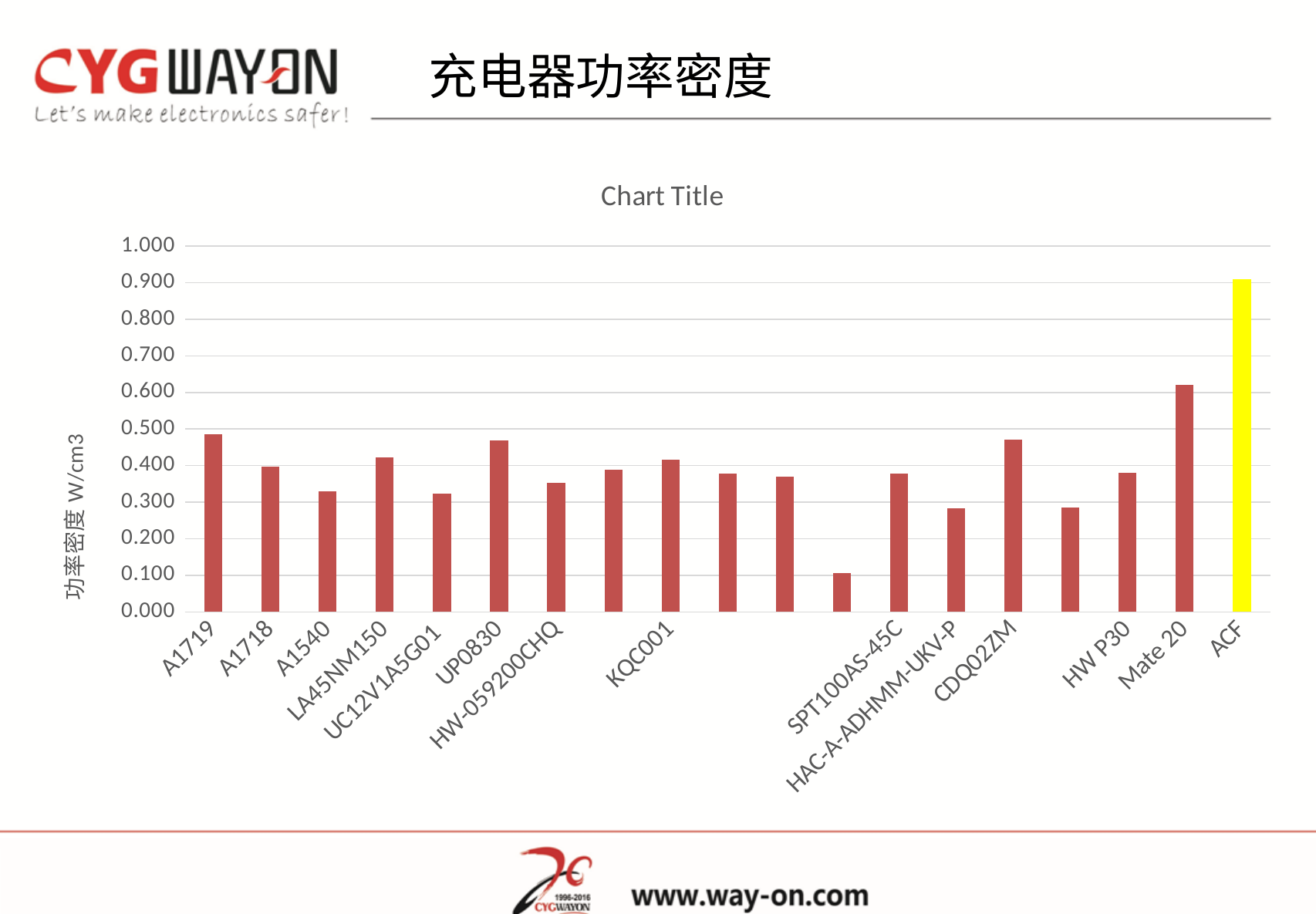
Is the value for Mate 20 greater or less than 0.500? greater Is the value for A1719 greater or less than 0.500? less Which category has the highest value in the chart? ACF Is the value for ACF greater or less than 0.800? greater Which has the larger value, Mate 20 or CDQ02ZM? Mate 20 What kind of chart is shown on the slide? bar chart How many bars are plotted in the chart? 19 What is the label on the vertical axis of the chart? 功率密度 W/cm3 What colour is the bar for ACF? yellow Which has the larger value, A1719 or A1718? A1719